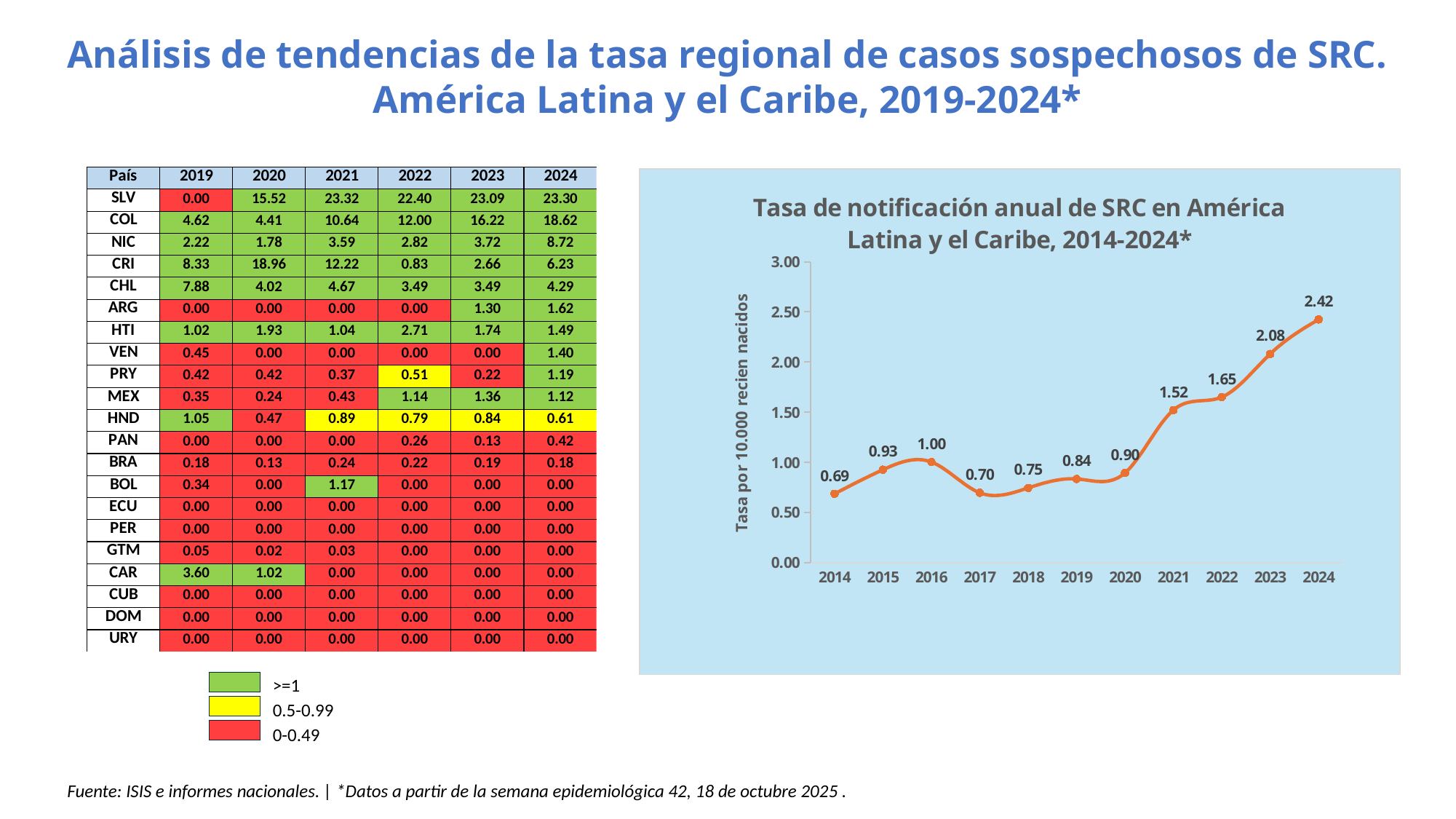
In the line chart, what is the difference between the 2024 and 2023 values? 0.34 In the line chart, which year has the highest notification rate? 2024 In the line chart, which year has a higher value, 2016 or 2017? 2016 In the line chart, is the value for 2022 greater or less than 1.50? greater In the line chart, what is the difference between the 2021 and 2020 values? 0.62 In the line chart, do the values rise or fall from 2020 to 2024? Rise How many years are plotted in the line chart? 11 In the line chart, which year has the lowest notification rate? 2014 In the line chart, what is the notification rate for 2021? 1.52 What type of chart is shown on the right side of the slide? Line chart In the line chart, what is the notification rate for 2024? 2.42 In the line chart, what is the notification rate for 2017? 0.70